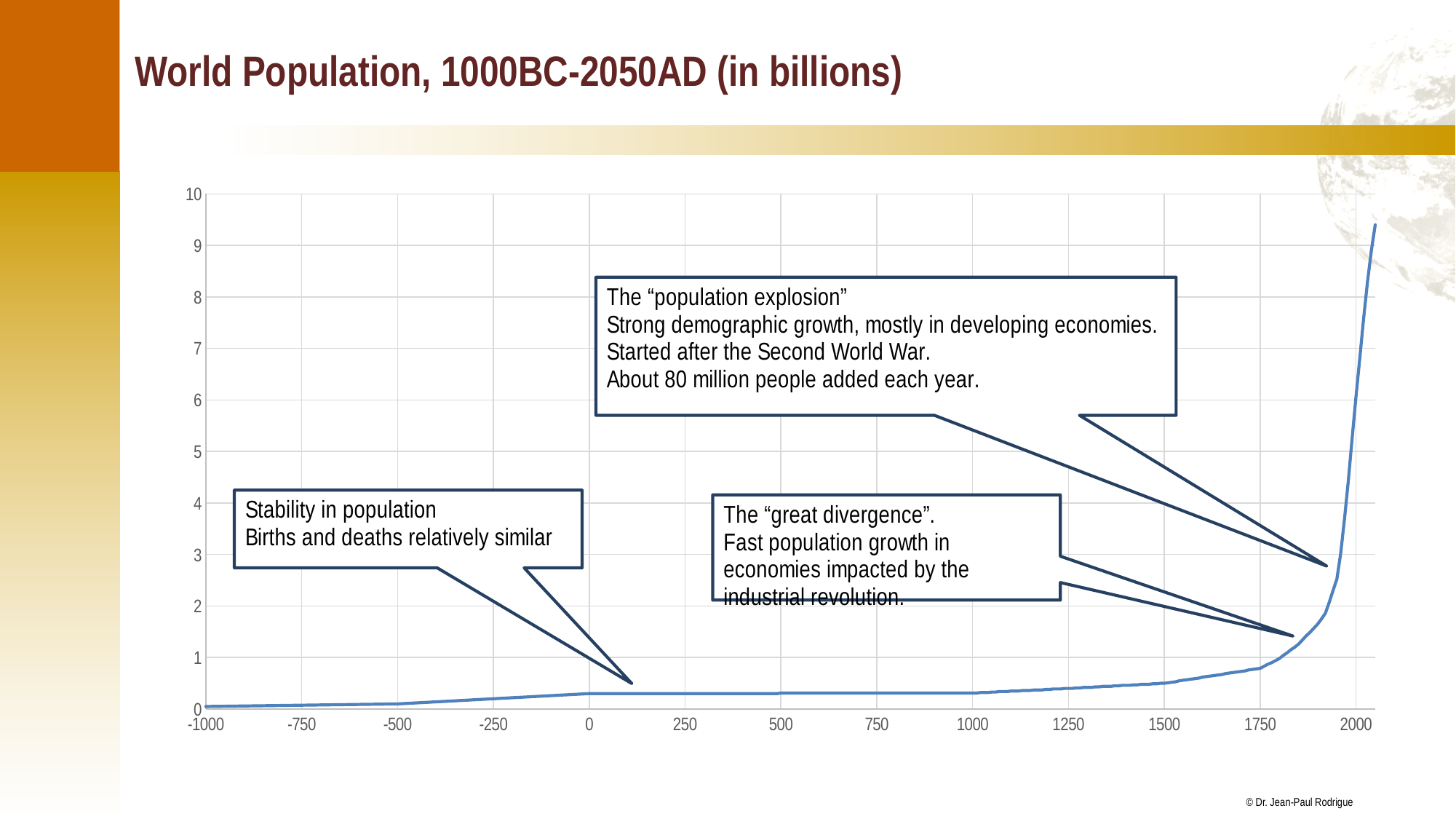
What is the title of the chart on the slide? World Population, 1000BC-2050AD (in billions) At which end of the x axis does the line reach its highest value? The right end (around 2050) Is the value at year 2000 larger or smaller than the value at year 1750? Larger Is the world population value at year 1500 greater or less than 1 billion? less Is the world population value at year 2000 greater or less than 5 billion? greater Do the values on the chart generally rise or fall as the years move from -1000 to 2050? Rise At which end of the x axis is the line at its lowest value? The left end (-1000) Is the world population value at the right end of the line (around 2050) greater or less than 8 billion? greater What kind of chart is shown on the slide? Line chart What is the highest value shown on the y axis of the chart? 10